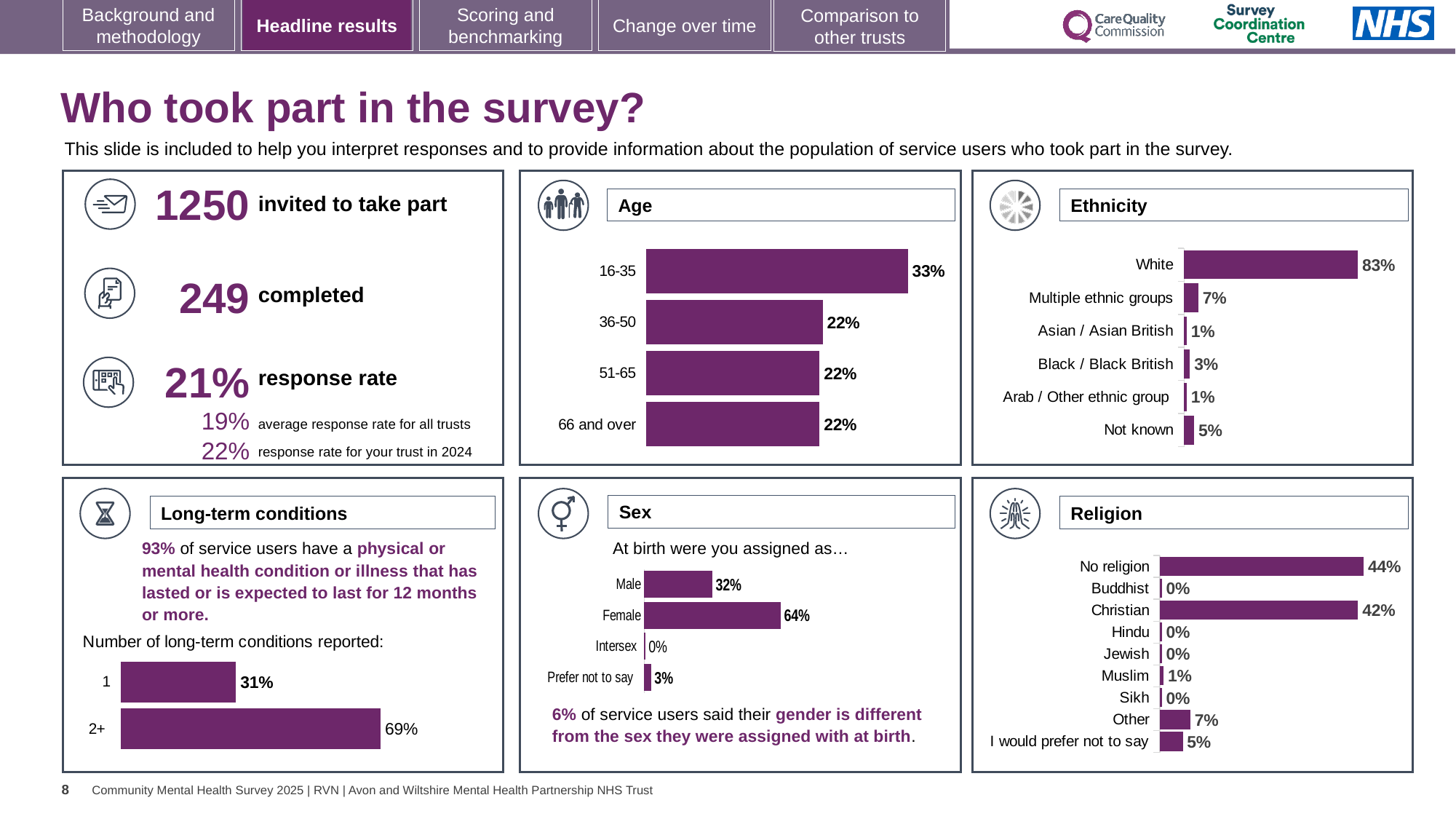
In the Ethnicity chart, what is the difference between the White and Multiple ethnic groups percentages? 76% In the Long-term conditions chart, what percentage of service users reported 2+ long-term conditions? 69% In the Age chart, which age group has the highest percentage? 16-35 In the Sex chart, what percentage of respondents were assigned Female at birth? 64% In the Age chart, what percentage of respondents were aged 16-35? 33% In the Ethnicity chart, what percentage of respondents were White? 83% In the Religion chart, which category has the highest percentage? No religion How many categories are shown in the Religion chart? 9 In the Sex chart, which is larger, Male or Female? Female In the Religion chart, what percentage of respondents reported No religion? 44% How many categories are shown in the Ethnicity chart? 6 What type of chart is used in the Age panel? Bar chart